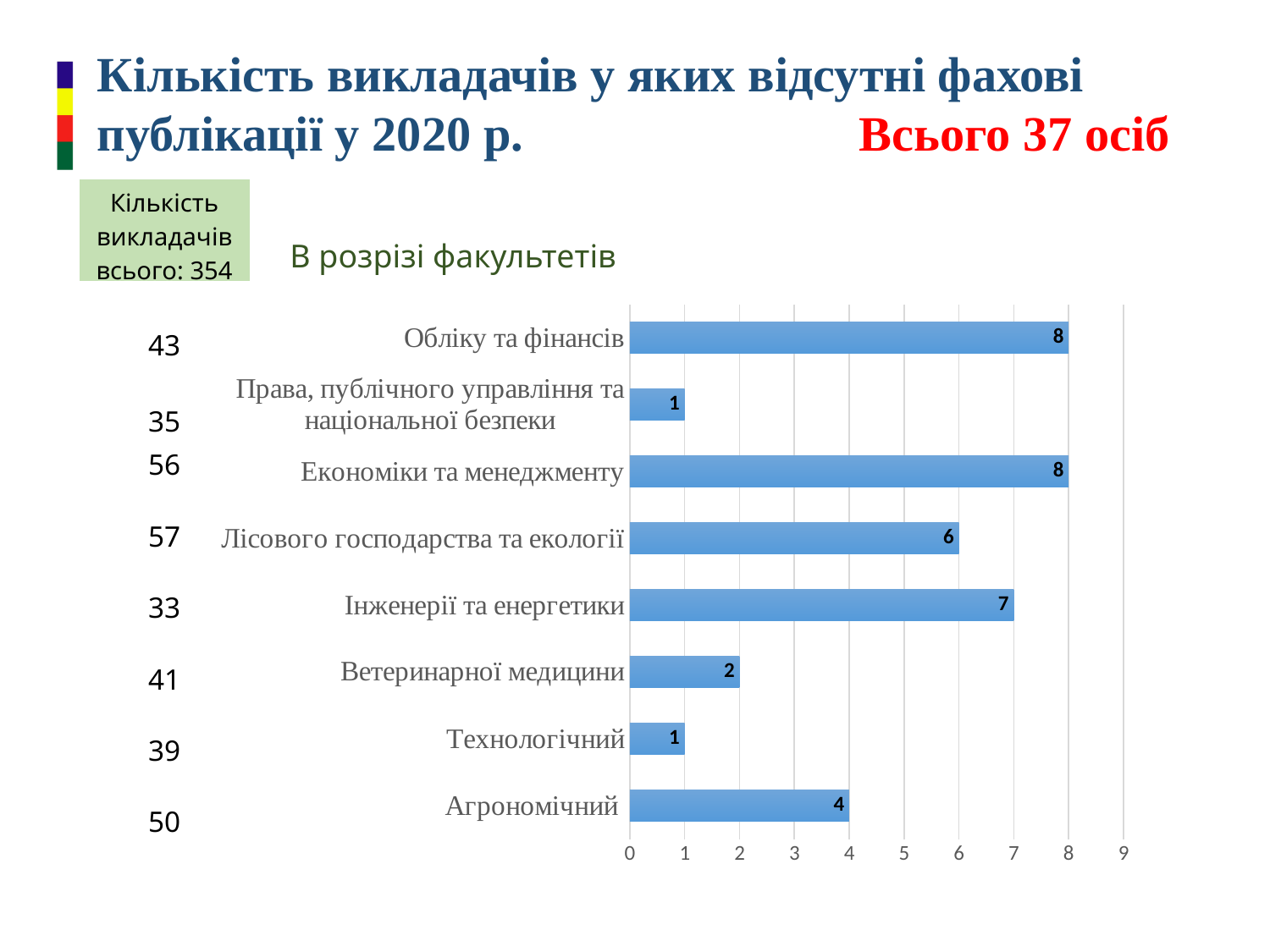
Is the value for Економіки та менеджменту greater or less than 5? greater What is the difference between the values for Інженерії та енергетики and Агрономічний? 3 What is the value for Лісового господарства та екології? 6 What is the value for Обліку та фінансів? 8 What is the value for Інженерії та енергетики? 7 Which has a larger value, Лісового господарства та екології or Ветеринарної медицини? Лісового господарства та екології What type of chart is shown on the slide? bar chart What is the value for Ветеринарної медицини? 2 According to the slide title, what is the total number of people (Всього)? 37 осіб What is the highest value shown in the chart? 8 What is the value for Агрономічний? 4 How many faculties (categories) are shown in the chart? 8